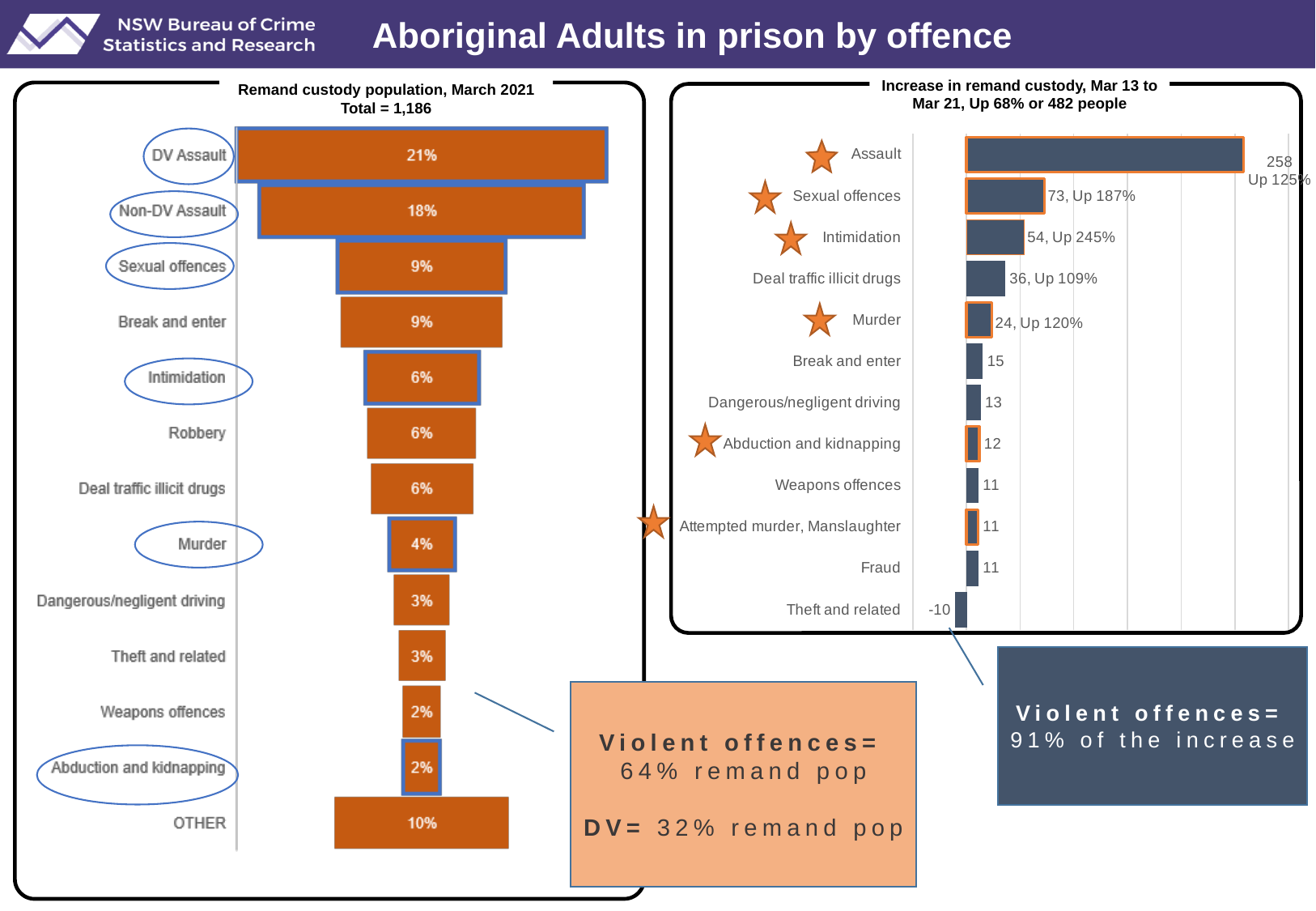
In the 'Remand custody population, March 2021' chart, what is the difference in percentage points between DV Assault and Non-DV Assault? 3 percentage points In the 'Increase in remand custody, Mar 13 to Mar 21' chart, what is the difference between the increase for Assault and the increase for Sexual offences? 185 In the 'Increase in remand custody, Mar 13 to Mar 21' chart, what percentage increase is shown for Intimidation? Up 245% In the 'Remand custody population, March 2021' chart, what is the total remand population stated in the title? 1,186 What kind of chart is the 'Increase in remand custody, Mar 13 to Mar 21' chart? Bar chart In the 'Remand custody population, March 2021' chart, how many offence categories are listed, including OTHER? 13 In the 'Remand custody population, March 2021' chart, what percentage is shown for Murder? 4% In the 'Increase in remand custody, Mar 13 to Mar 21' chart, what is the increase shown for Assault? 258 In the 'Remand custody population, March 2021' chart, which named offence category (excluding OTHER) has the highest share? DV Assault In the 'Increase in remand custody, Mar 13 to Mar 21' chart, which is larger, the increase for Sexual offences or for Intimidation? Sexual offences In the 'Remand custody population, March 2021' chart, what percentage is shown for DV Assault? 21% In the 'Increase in remand custody, Mar 13 to Mar 21' chart, which offence has the lowest value? Theft and related